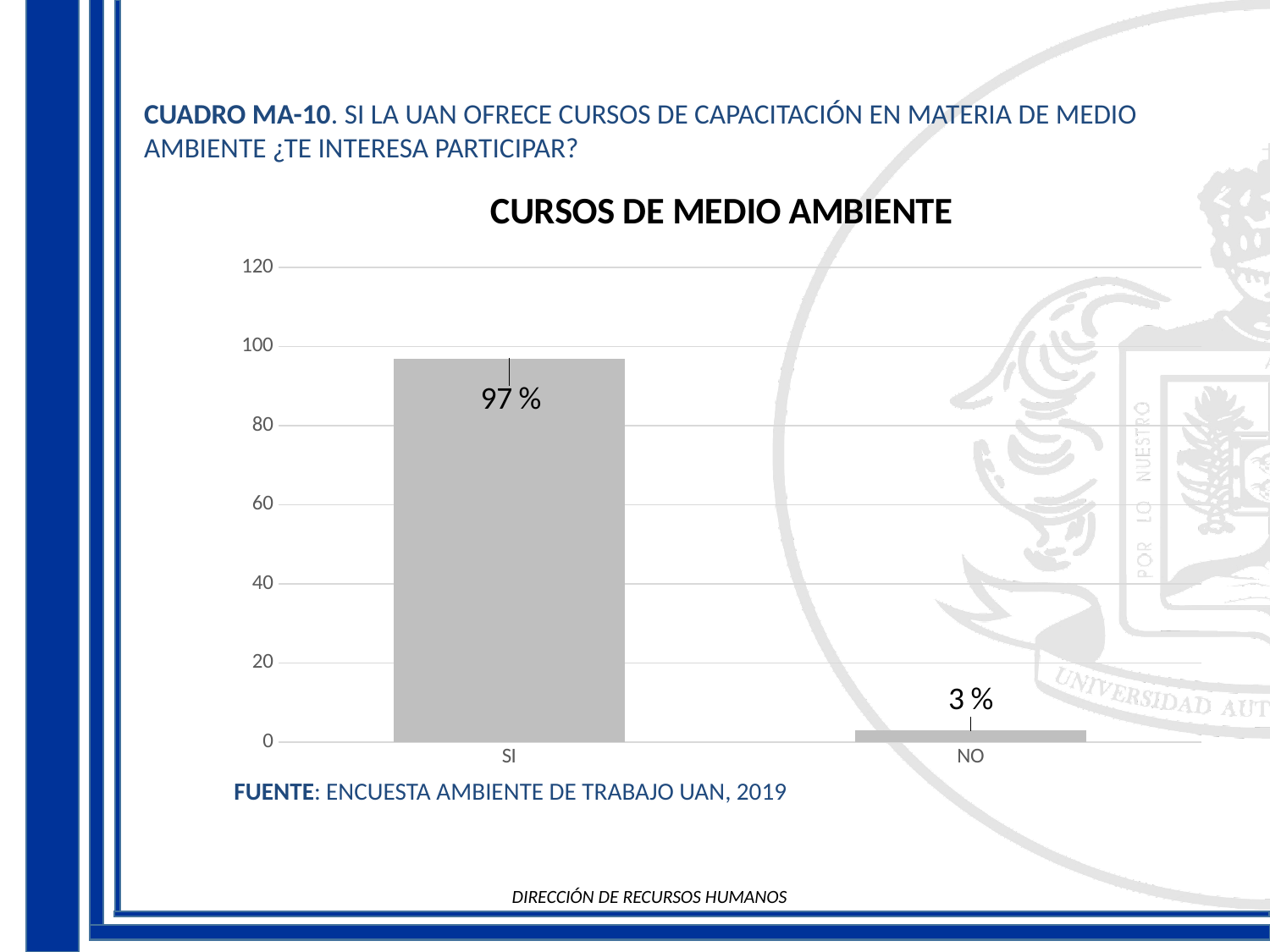
Is the value for NO greater or less than 20? less What is the highest value shown on the y axis? 120 Which category has the lowest value? NO What kind of chart is shown? bar chart What is the title of the chart? CURSOS DE MEDIO AMBIENTE Which is larger, the value for SI or the value for NO? SI What is the difference between the values for SI and NO? 94 % What is the value for SI? 97 % Is the value for SI greater or less than 80? greater How many categories are shown on the x axis? 2 What is the value for NO? 3 % Which category has the highest value? SI